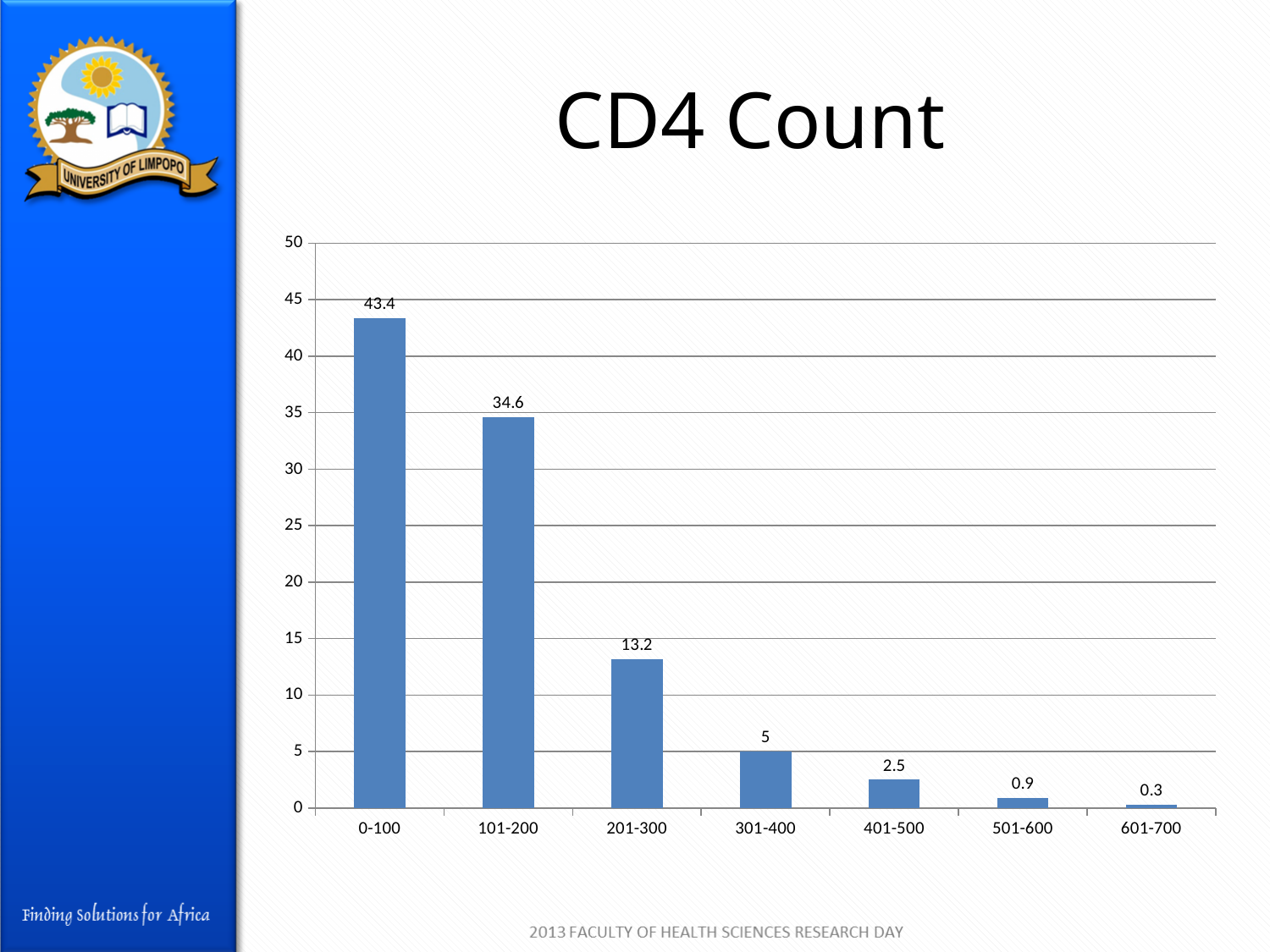
What is the value for the 201-300 category? 13.2 What is the value for the 401-500 category? 2.5 Which CD4 count category has the lowest value? 601-700 What kind of chart is shown on the slide? bar chart What is the value for the 0-100 CD4 count category? 43.4 Which is larger, the value for 101-200 or the value for 201-300? 101-200 How many CD4 count categories are shown on the x axis? 7 Do the values rise or fall as the CD4 count categories increase along the x axis? fall Which CD4 count category has the highest value? 0-100 What is the difference between the values for 301-400 and 501-600? 4.1 What is the difference between the values for 0-100 and 101-200? 8.8 Is the value for 101-200 greater or less than 30? greater